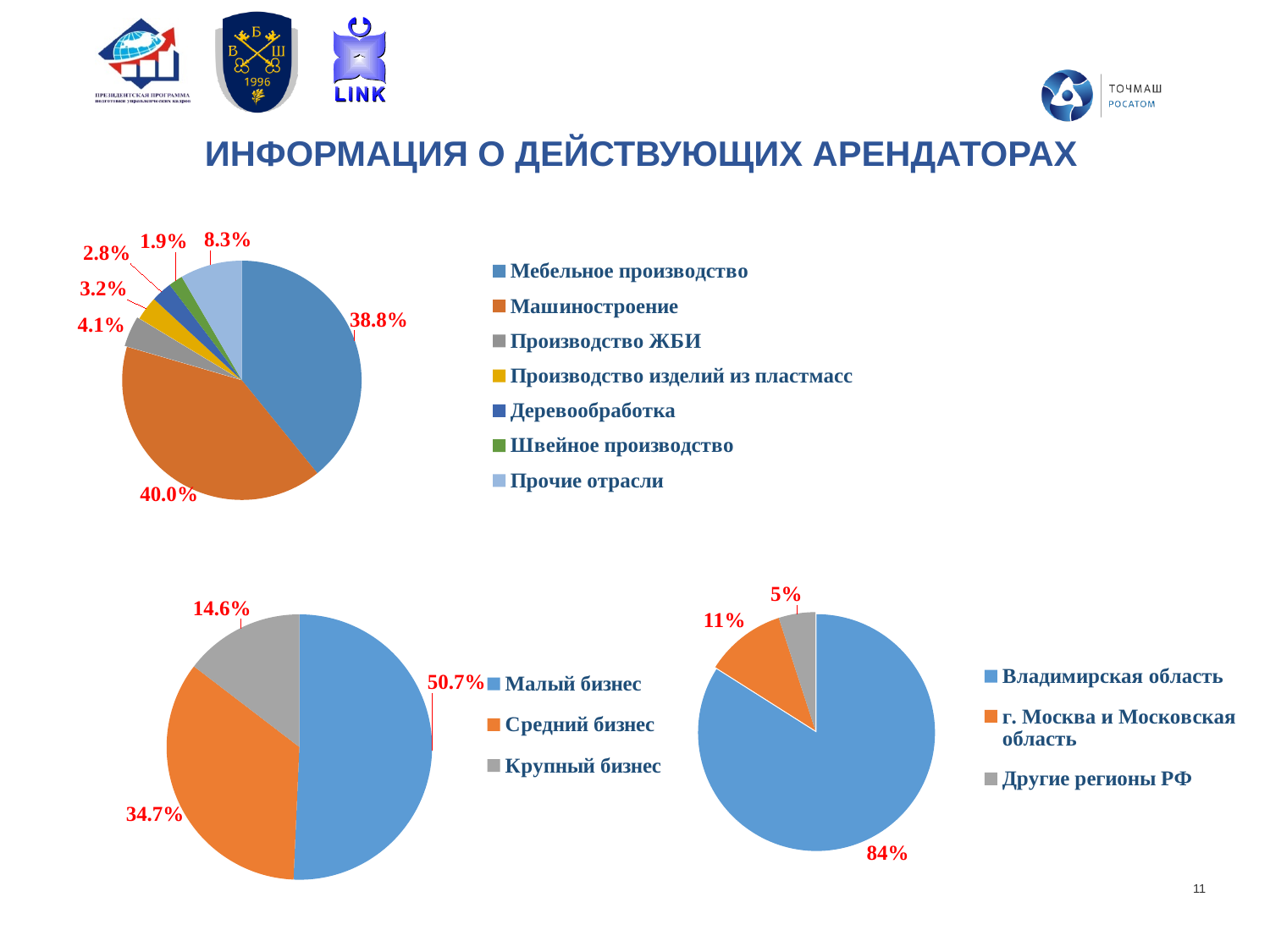
In the bottom-right pie chart, what share does Владимирская область have? 84% In the bottom-left pie chart, which category has the largest share? Малый бизнес In the top-left pie chart, what share does Прочие отрасли have? 8.3% In the bottom-right pie chart, which is larger: г. Москва и Московская область or Другие регионы РФ? г. Москва и Московская область In the top-left pie chart, how many categories does the legend list? 7 In the bottom-left pie chart, what share does Средний бизнес have? 34.7% In the top-left pie chart, what share does Мебельное производство have? 38.8% In the top-left pie chart, which category has the smallest share? Швейное производство In the top-left pie chart, what share does Машиностроение have? 40.0% What type of chart is the bottom-right chart? Pie chart In the bottom-left pie chart, what is the difference between the shares of Малый бизнес and Крупный бизнес? 36.1% In the top-left pie chart, what is the difference between the shares of Производство ЖБИ and Деревообработка? 1.3%